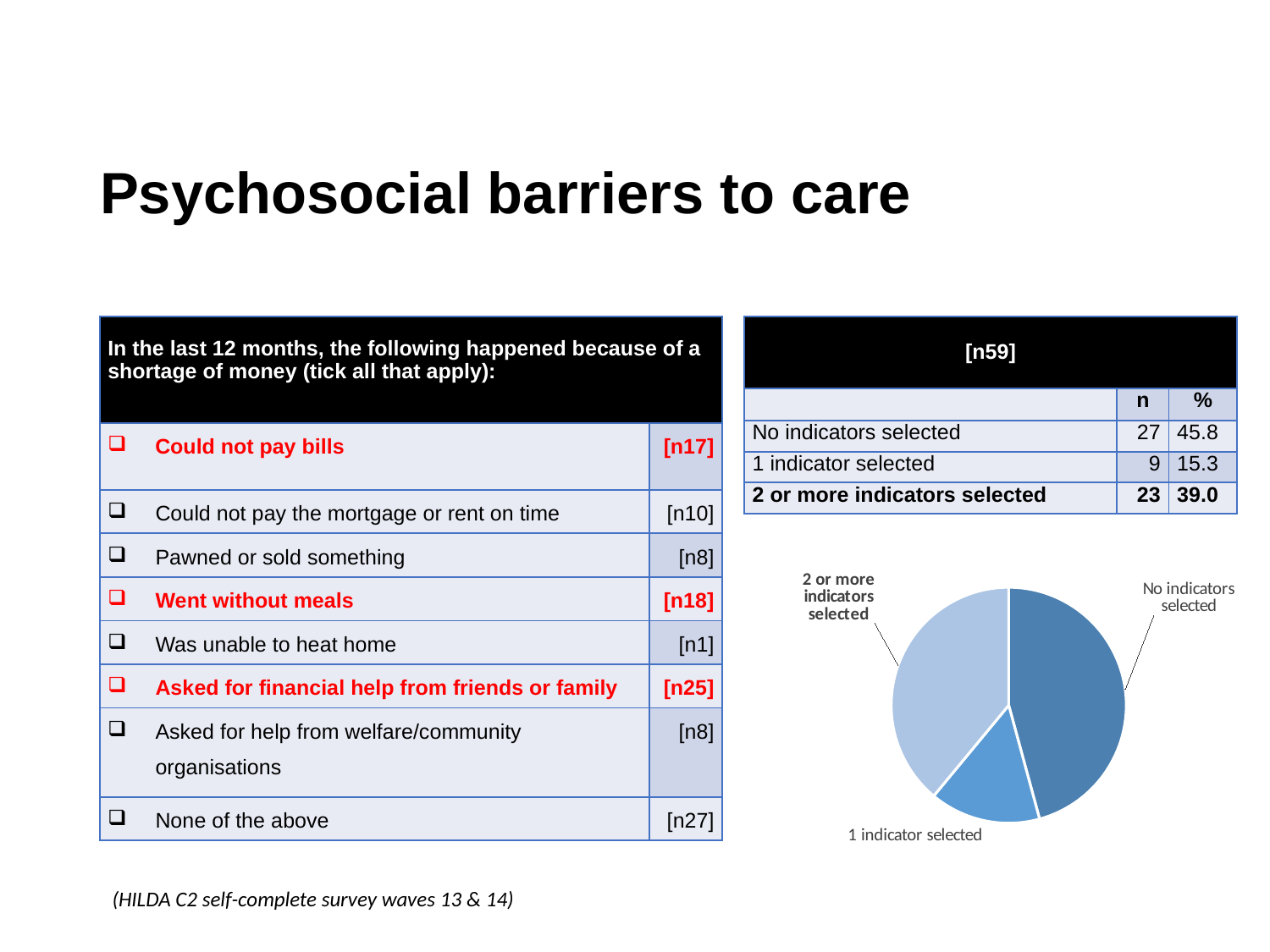
What is the total n shown in the header of the table above the pie chart? [n59] In the pie chart, which slice is larger: 'No indicators selected' or '1 indicator selected'? No indicators selected In the pie chart, which slice is larger: '2 or more indicators selected' or '1 indicator selected'? 2 or more indicators selected How many slices does the pie chart have? 3 Which category has the smallest slice in the pie chart? 1 indicator selected According to the table above the pie chart, what is the n value for '1 indicator selected'? 9 Which slice of the pie chart is labelled at the bottom of the chart? 1 indicator selected Which category has the largest slice in the pie chart? No indicators selected What kind of chart is shown on the slide? pie chart According to the table above the pie chart, what percentage share does 'No indicators selected' have? 45.8 According to the table above the pie chart, what percentage share does '2 or more indicators selected' have? 39.0